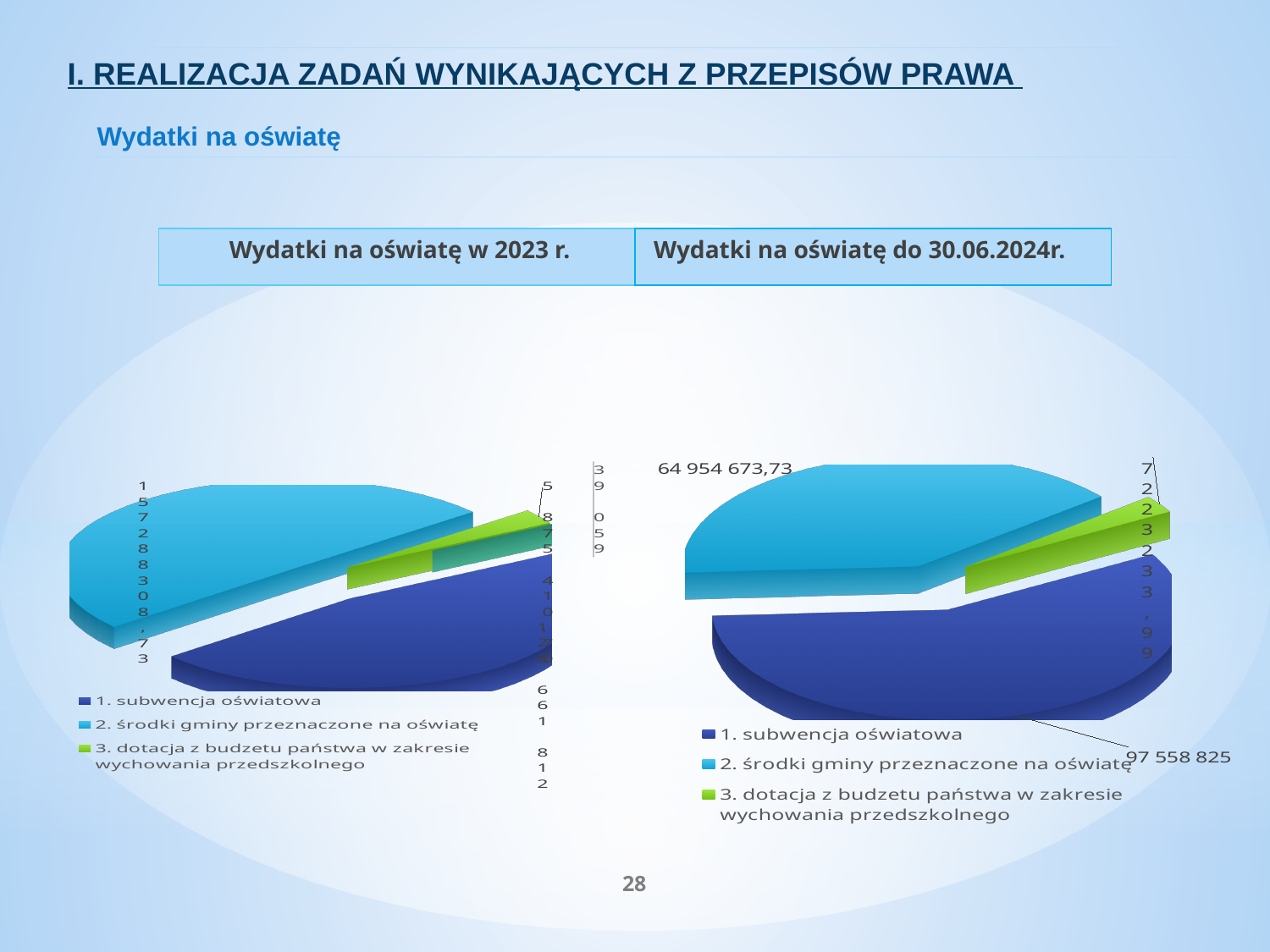
What kind of chart is used for 'Wydatki na oświatę do 30.06.2024r.'? pie chart In the chart 'Wydatki na oświatę do 30.06.2024r.', which category has the smallest slice? 3. dotacja z budżetu państwa w zakresie wychowania przedszkolnego In the chart 'Wydatki na oświatę do 30.06.2024r.', which is larger: '1. subwencja oświatowa' or '2. środki gminy przeznaczone na oświatę'? 1. subwencja oświatowa In the chart 'Wydatki na oświatę w 2023 r.', which colour represents '1. subwencja oświatowa'? dark blue How many categories does the legend of the chart 'Wydatki na oświatę w 2023 r.' list? 3 In the chart 'Wydatki na oświatę w 2023 r.', which category has the smallest slice? 3. dotacja z budżetu państwa w zakresie wychowania przedszkolnego What kind of chart is used for 'Wydatki na oświatę w 2023 r.'? pie chart In the chart 'Wydatki na oświatę do 30.06.2024r.', what is the value for '1. subwencja oświatowa'? 97 558 825 In the chart 'Wydatki na oświatę do 30.06.2024r.', what is the difference between '1. subwencja oświatowa' and '2. środki gminy przeznaczone na oświatę'? 32 604 151,27 In the chart 'Wydatki na oświatę do 30.06.2024r.', which category has the largest slice? 1. subwencja oświatowa In the chart 'Wydatki na oświatę do 30.06.2024r.', what is the value for '2. środki gminy przeznaczone na oświatę'? 64 954 673,73 In the chart 'Wydatki na oświatę do 30.06.2024r.', which colour represents '3. dotacja z budżetu państwa w zakresie wychowania przedszkolnego'? green